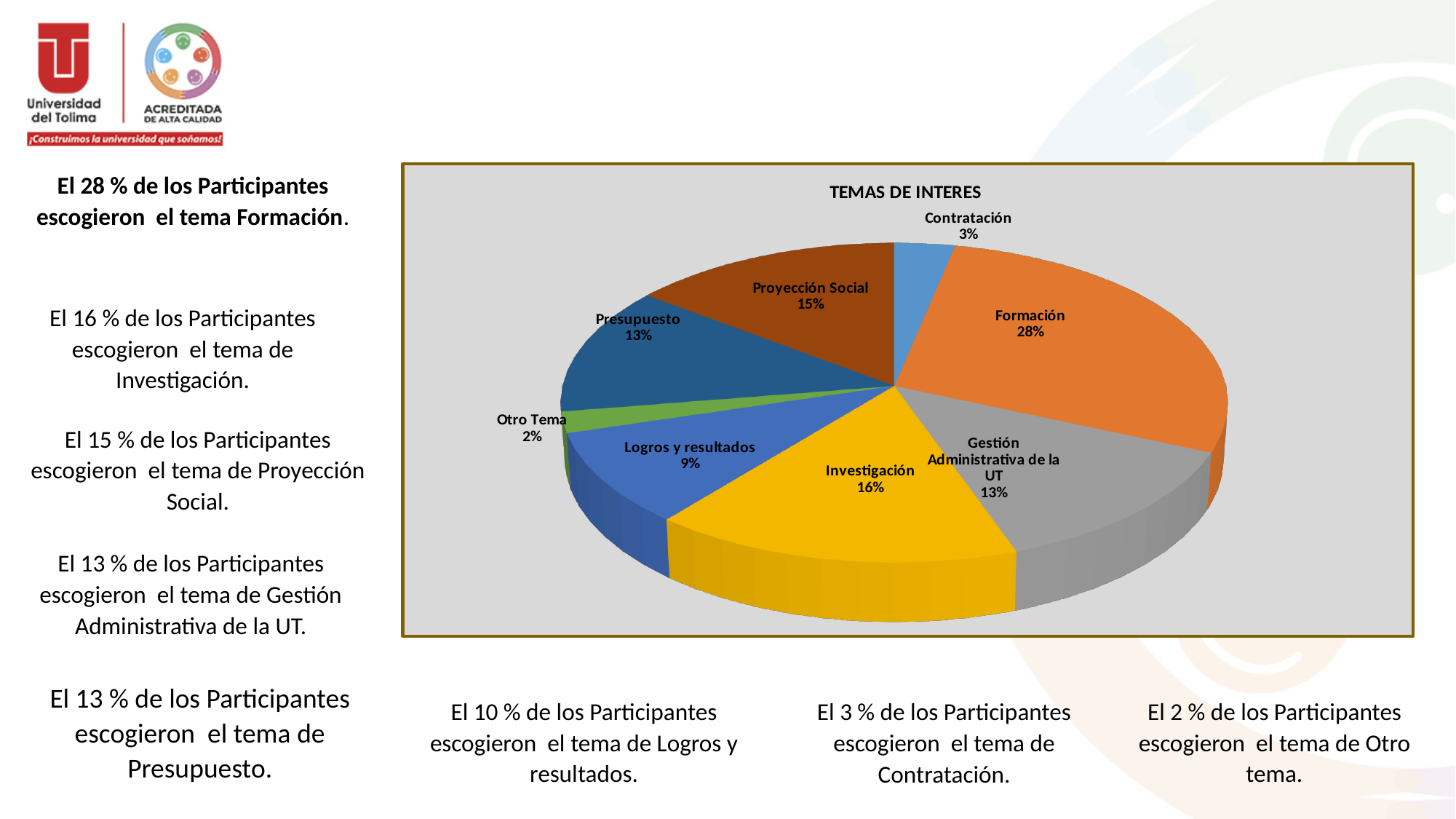
What is the value shown for Logros y resultados? 9% What is the title of the chart? TEMAS DE INTERES What percentage of the pie does Formación represent? 28% How many slices does the pie chart have? 8 What is the value shown for Investigación? 16% Which slice of the pie is the largest? Formación Which slice of the pie is the smallest? Otro Tema What type of chart is shown on the slide? Pie chart What is the value shown for Contratación? 3% What is the value shown for Proyección Social? 15% What is the difference between the Formación and Investigación percentages? 12% Which is larger, Proyección Social or Presupuesto? Proyección Social